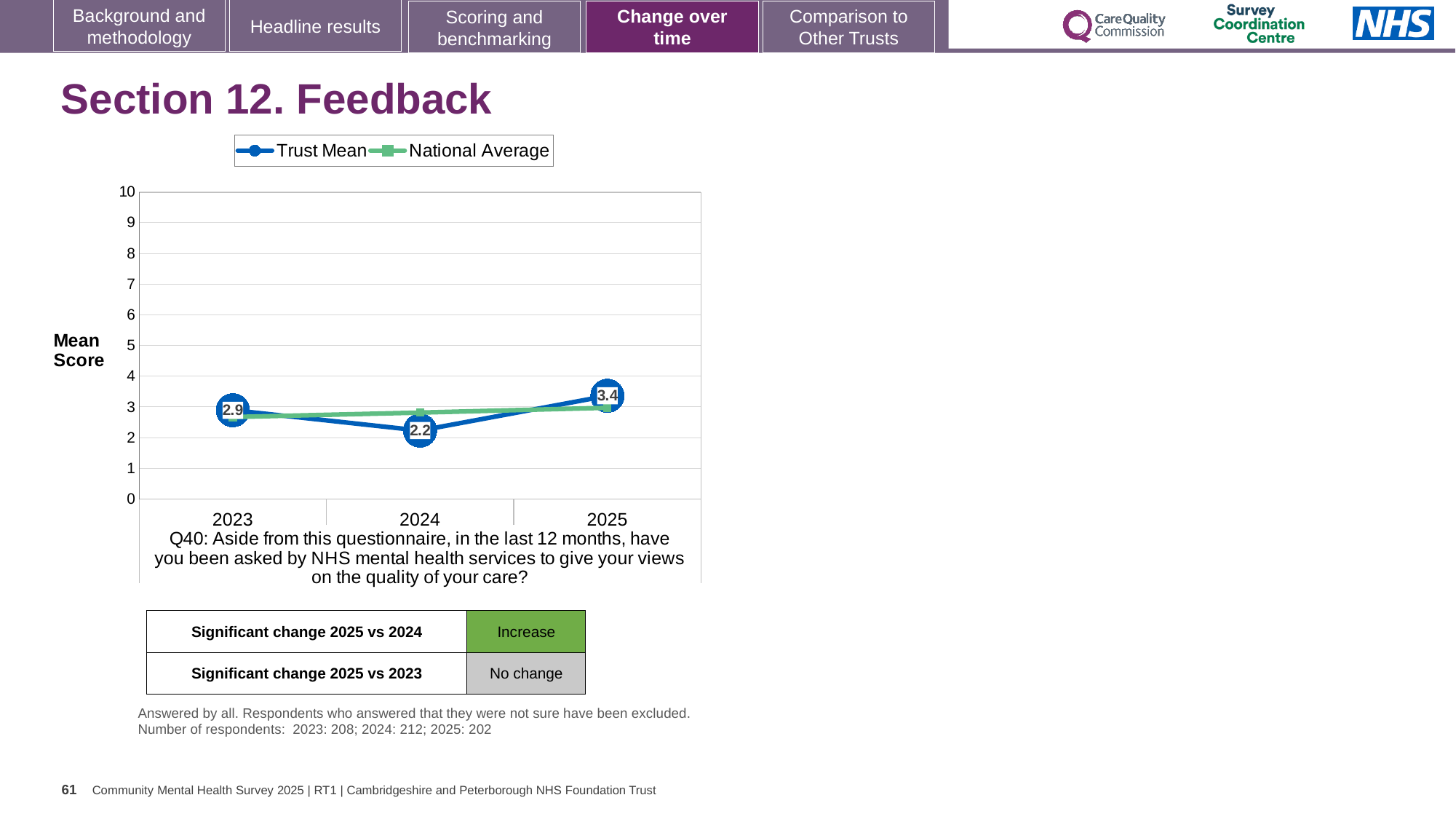
What is the Trust Mean score for 2025? 3.4 How many series does the legend list? 2 What is the difference between the Trust Mean in 2025 and in 2024? 1.2 How many years are shown on the x axis? 3 Which is larger, the Trust Mean in 2023 or in 2024? 2023 In which year is the Trust Mean highest? 2025 In which year is the Trust Mean lowest? 2024 What kind of chart is shown? line chart Is the National Average value for 2025 greater or less than 4? less Does the Trust Mean rise or fall from 2024 to 2025? rise What is the Trust Mean score for 2024? 2.2 What is the Trust Mean score for 2023? 2.9